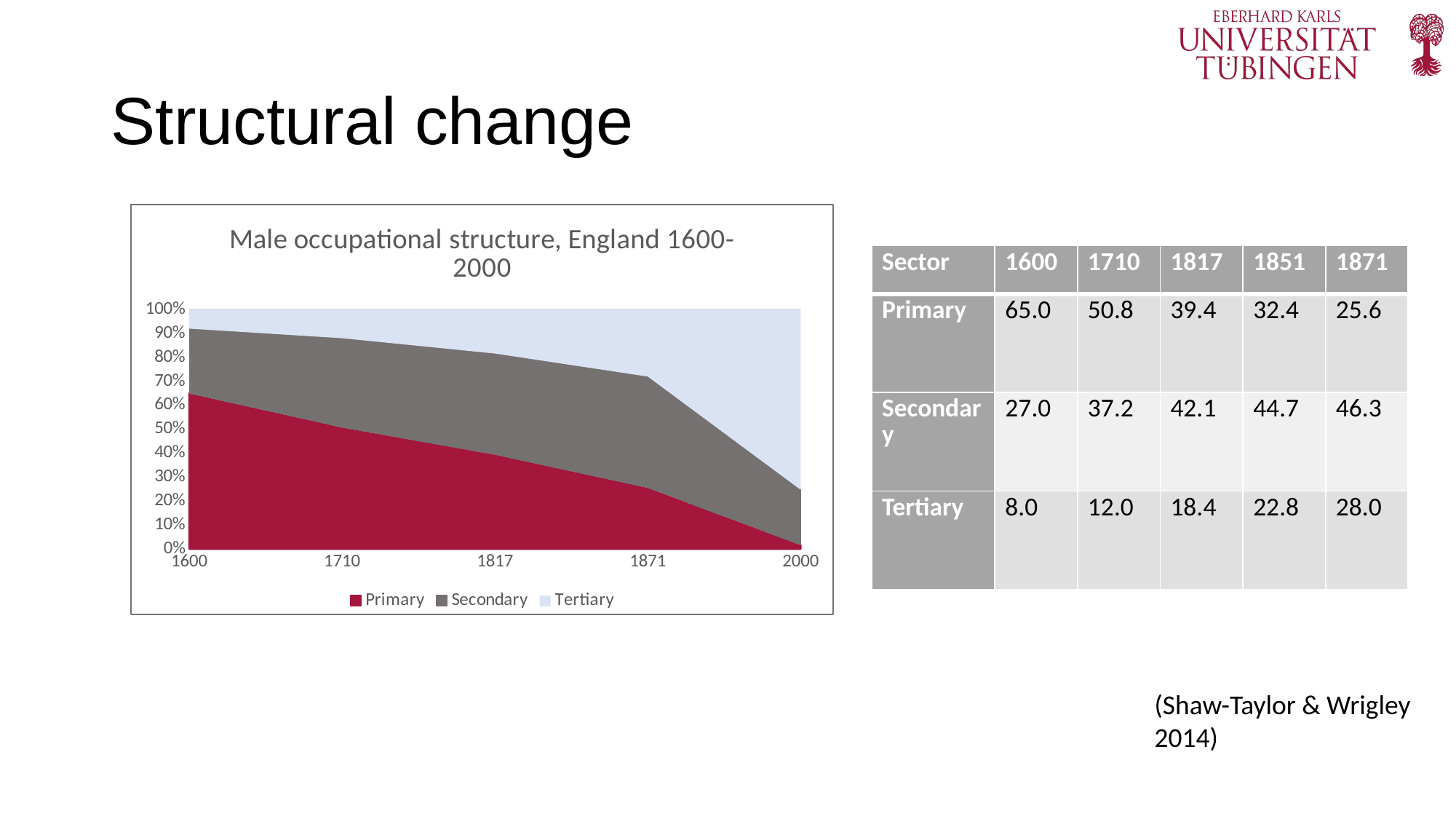
In 1600, which is larger, the Primary share or the Secondary share? Primary According to the table on the slide, what is the Primary value for 1600? 65.0 What kind of chart is shown on the slide? Area chart Is the Primary share in 1600 greater or less than 60%? greater How many series does the legend of the chart list? 3 In which year shown is the Primary share highest? 1600 Is the Primary share in 2000 greater or less than 10%? less What is the title of the chart? Male occupational structure, England 1600-2000 According to the table on the slide, what is the Tertiary value for 1871? 28.0 Does the Primary share rise or fall from 1600 to 2000 in the chart? Fall Using the table values, what is the difference between the Primary value in 1600 and in 1871? 39.4 How many years are marked on the x axis of the chart? 5